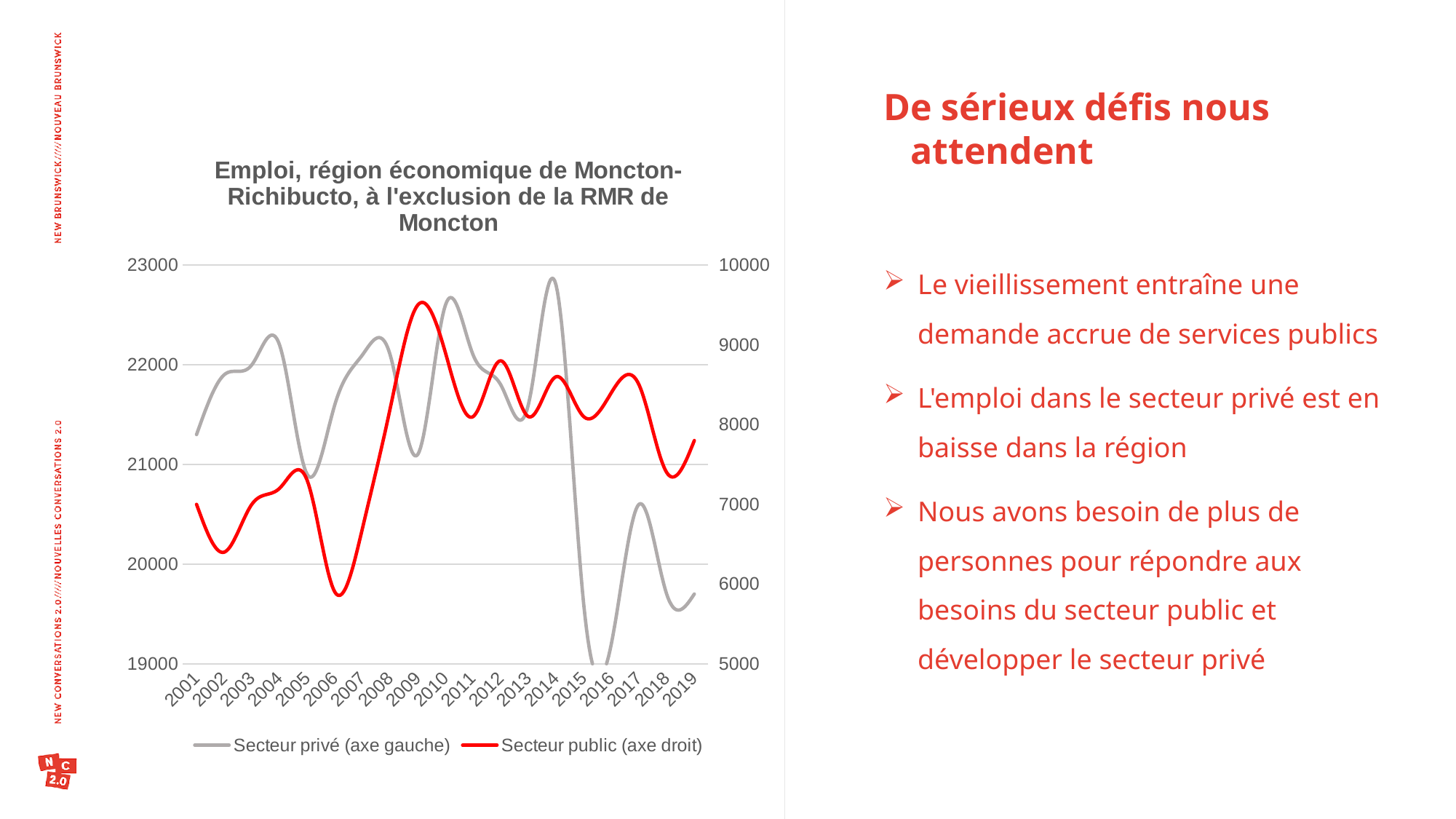
In which year does the Secteur privé series reach its lowest value? 2016 In which year does the Secteur privé series reach its highest value? 2014 In which year does the Secteur public series reach its highest value? 2009 How many series does the legend list? 2 Is the Secteur public value for 2009 greater or less than 9000? greater Which axis does the legend say the Secteur public series is plotted on? axe droit Is the Secteur privé value for 2018 greater or less than 20000? less What kind of chart is shown on the slide? Line chart How many years are plotted along the x axis? 19 Is the Secteur public value for 2002 greater or less than 7000? less In which year does the Secteur public series reach its lowest value? 2006